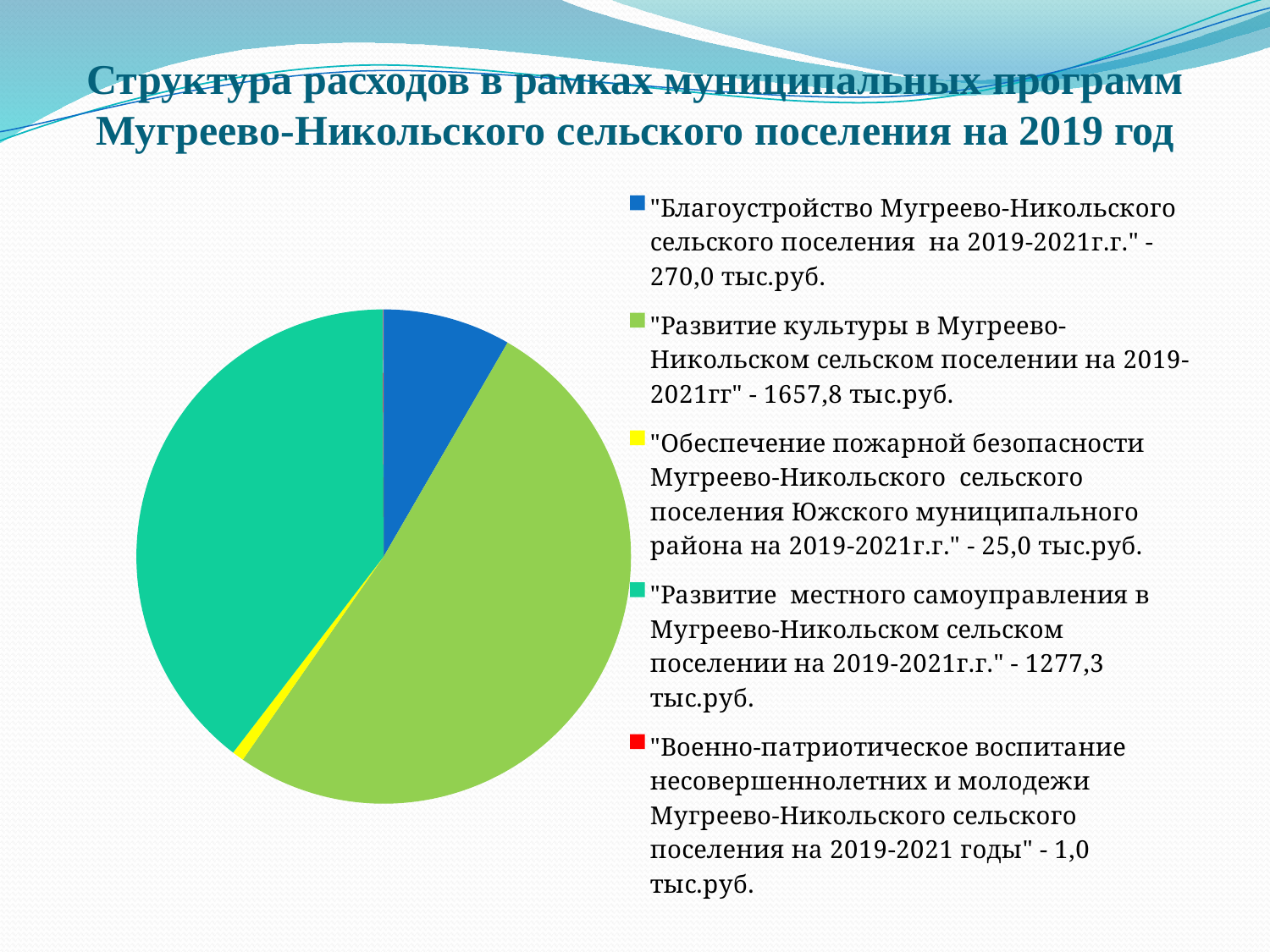
What colour is the slice for "Развитие культуры в Мугреево-Никольском сельском поселении на 2019-2021гг"? green What is the value for "Развитие местного самоуправления в Мугреево-Никольском сельском поселении на 2019-2021г.г."? 1277,3 тыс.руб. What is the difference between the values for "Развитие культуры" and "Развитие местного самоуправления"? 380,5 тыс.руб. What is the value for "Военно-патриотическое воспитание несовершеннолетних и молодежи Мугреево-Никольского сельского поселения на 2019-2021 годы"? 1,0 тыс.руб. Which is larger: the value for "Благоустройство" or the value for "Обеспечение пожарной безопасности"? Благоустройство What is the value for "Развитие культуры в Мугреево-Никольском сельском поселении на 2019-2021гг"? 1657,8 тыс.руб. Which program has the largest share of expenditures in the pie chart? Развитие культуры в Мугреево-Никольском сельском поселении на 2019-2021гг What is the value for "Благоустройство Мугреево-Никольского сельского поселения на 2019-2021г.г."? 270,0 тыс.руб. What is the value for "Обеспечение пожарной безопасности Мугреево-Никольского сельского поселения Южского муниципального района на 2019-2021г.г."? 25,0 тыс.руб. What kind of chart is shown on the slide? pie chart Which program has the smallest share of expenditures in the pie chart? Военно-патриотическое воспитание несовершеннолетних и молодежи Мугреево-Никольского сельского поселения на 2019-2021 годы